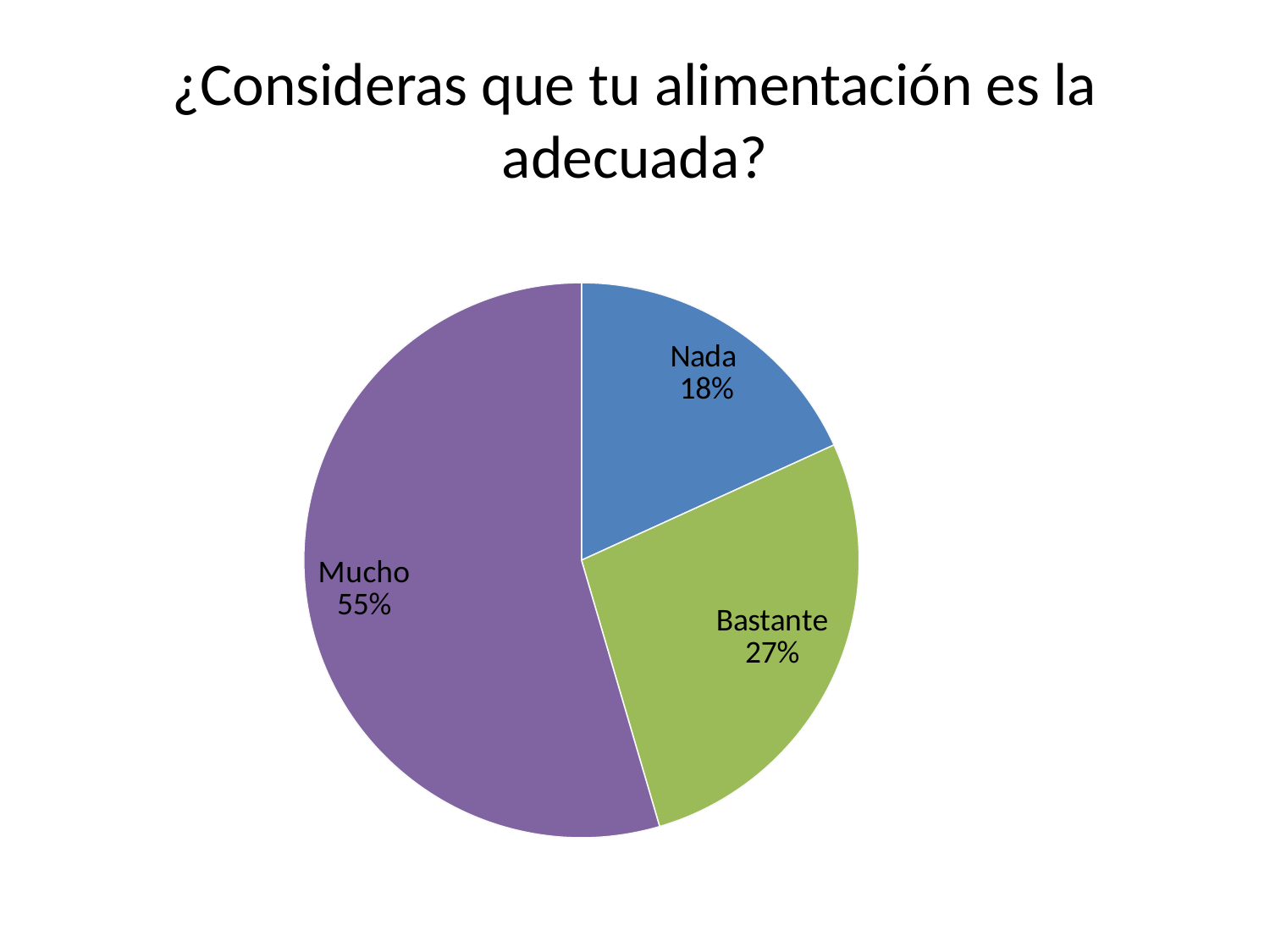
What share of the pie does the Mucho slice represent? 55% What is the difference in percentage points between the Mucho and Bastante slices? 28 What kind of chart is shown on the slide? Pie chart What share of the pie does the Nada slice represent? 18% What colour is the Mucho slice? Purple How many slices does the pie chart have? 3 Which category has the largest slice of the pie? Mucho What is the difference in percentage points between the Bastante and Nada slices? 9 What is the title of the slide? ¿Consideras que tu alimentación es la adecuada? What share of the pie does the Bastante slice represent? 27% Which category has the smallest slice of the pie? Nada Which slice is larger, Bastante or Nada? Bastante